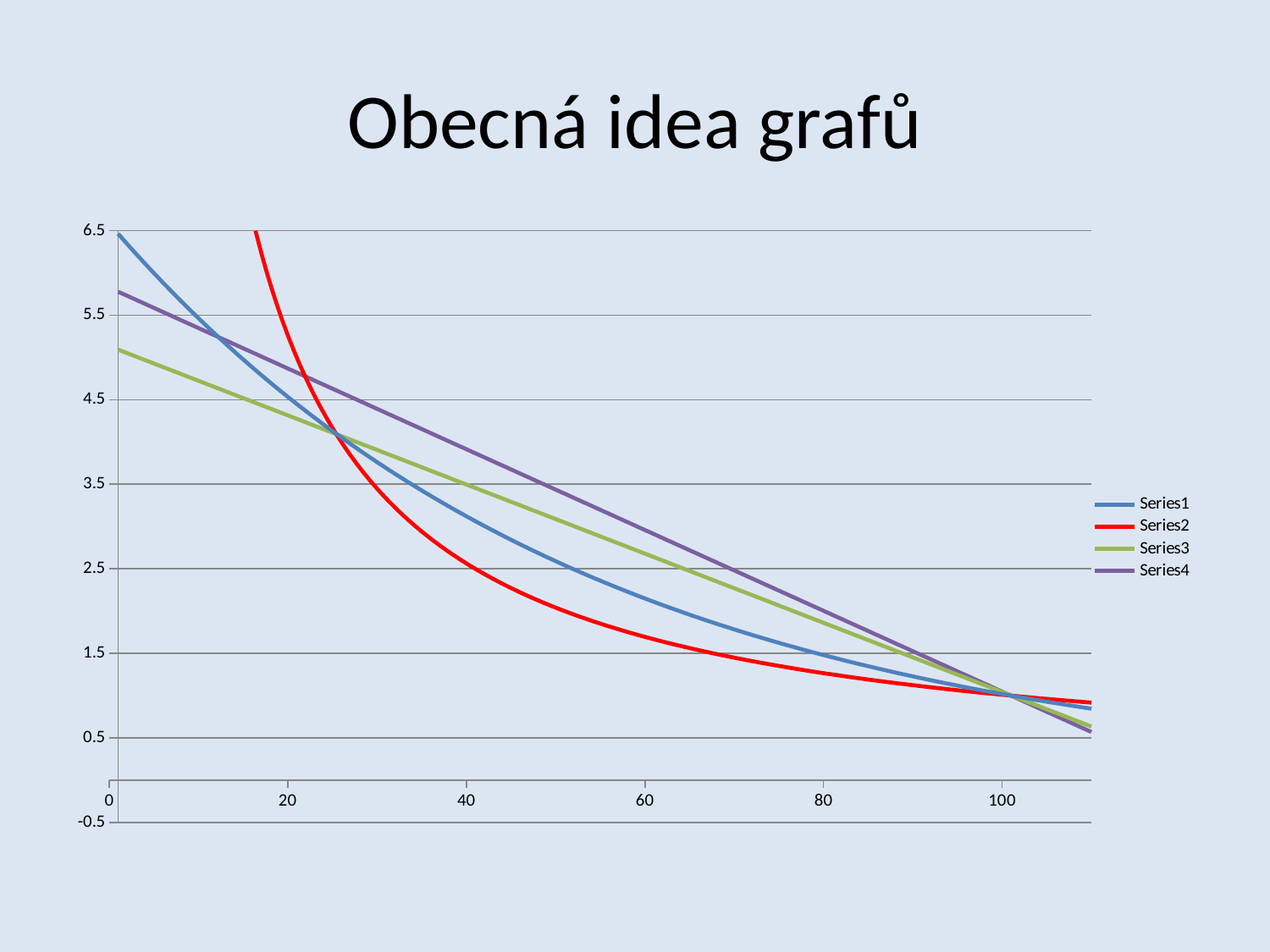
What colour is the line for Series2? red What kind of chart is shown on the slide? line chart Do the values of Series1 rise or fall as x increases from 0 to 100? fall Is the value of Series2 at x = 80 greater or less than 1.5? less What is the title of the slide? Obecná idea grafů How many series does the legend list? 4 At x = 60, which series has the lowest value? Series2 Is the value of Series4 at x = 40 greater or less than 3.5? greater Is the value of Series2 at x = 60 greater or less than 2.5? less Do the values of Series4 rise or fall along the x axis? fall At x = 60, which series has the highest value? Series4